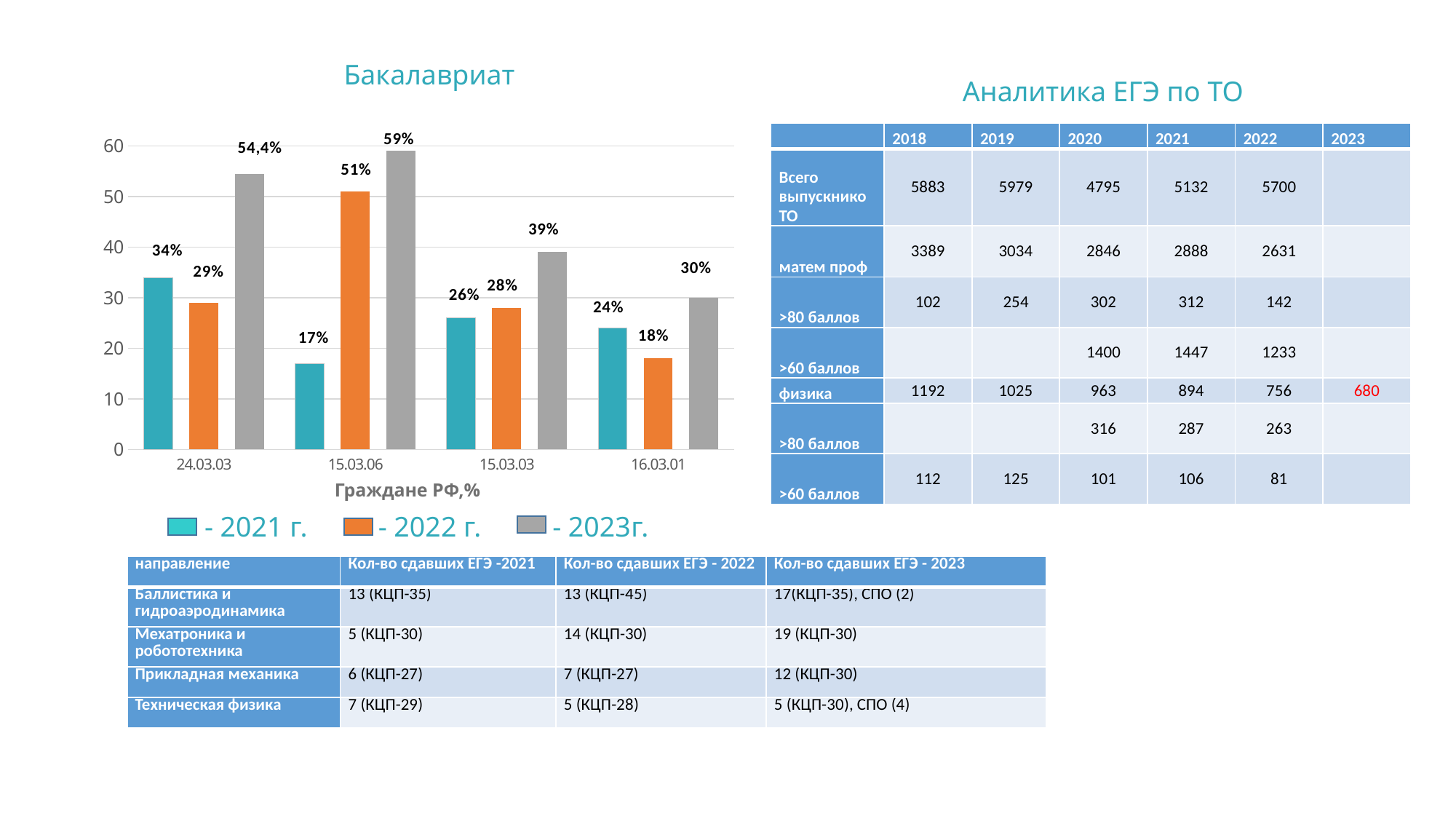
How many series does the chart's legend list? 3 Is the value for 15.03.03 in the 2023 series greater or less than 40? less What is the value for 16.03.01 in the 2022 series? 18% What is the value for 24.03.03 in the 2021 series? 34% What is the difference between the 2023 and 2021 values for 15.03.06? 42% What is the value for 15.03.06 in the 2023 series? 59% How many categories are shown on the x axis of the chart? 4 Which category has the lowest value in the 2021 series? 15.03.06 Which category has the highest value in the 2023 series? 15.03.06 Which is larger for 16.03.01: the 2021 value or the 2022 value? 2021 What is the value for 24.03.03 in the 2023 series? 54,4% What type of chart is shown under the title 'Бакалавриат'? bar chart